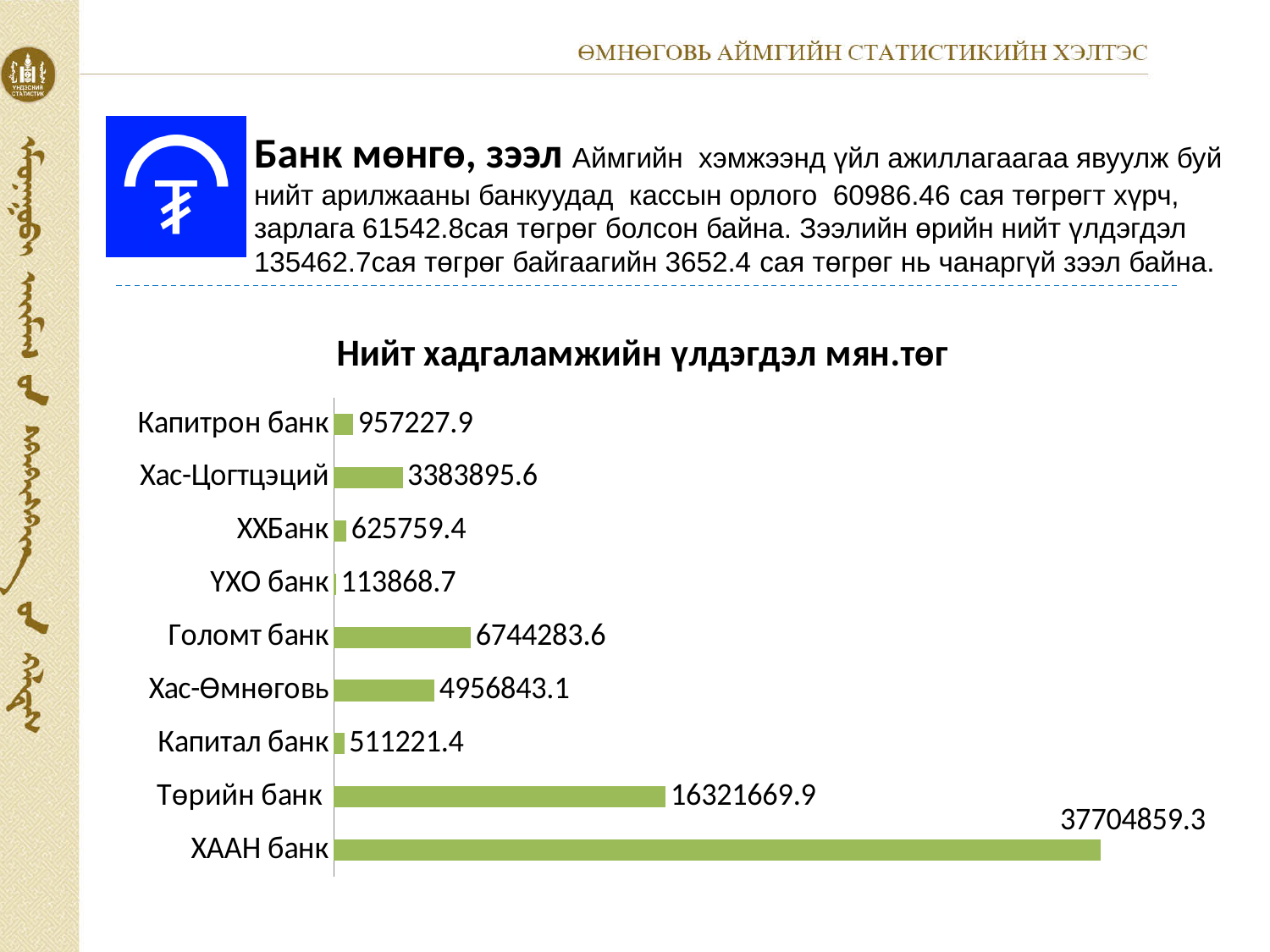
Which bank has the lowest value? ҮХО банк What is the value for ҮХО банк? 113868.7 Which is larger, the value for Капитал банк or the value for Капитрон банк? Капитрон банк What is the difference between the values for Голомт банк and Хас-Өмнөговь? 1787440.5 What is the value for Голомт банк? 6744283.6 What is the title of the chart? Нийт хадгаламжийн үлдэгдэл мян.төг How many banks are shown in the chart? 9 What is the value for ХААН банк? 37704859.3 What kind of chart is shown on the slide? Bar chart What is the difference between the values for ХААН банк and Төрийн банк? 21383189.4 Which bank has the highest value? ХААН банк What is the value for Хас-Цогтцэций? 3383895.6